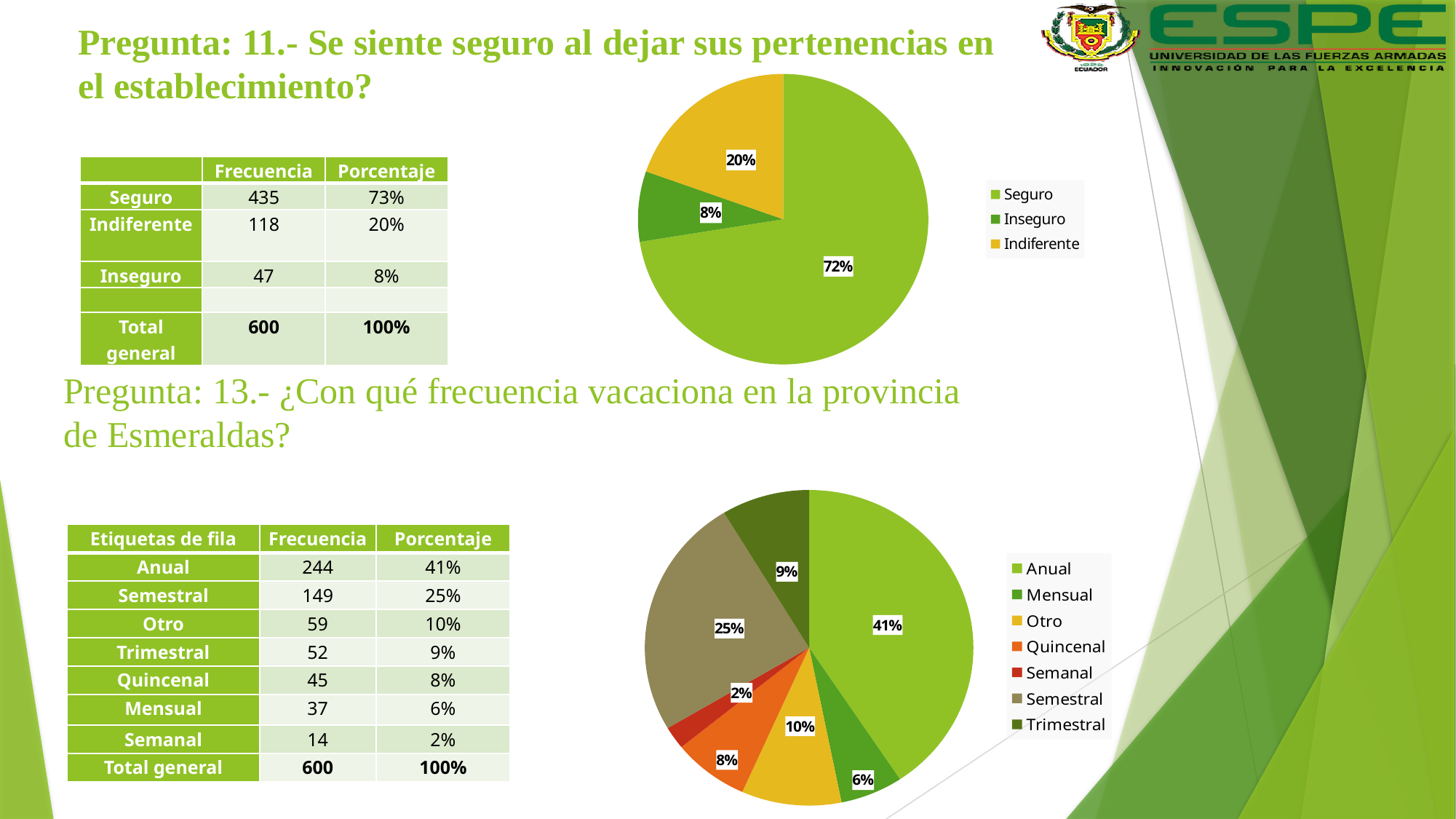
What kind of chart is the top chart (Pregunta 11)? Pie chart In the top pie chart (Pregunta 11), what percentage is shown for Indiferente? 20% In the top pie chart (Pregunta 11), what percentage is shown for Seguro? 72% In the bottom pie chart (Pregunta 13), which category has the smallest slice? Semanal In the bottom pie chart (Pregunta 13), what percentage is shown for Quincenal? 8% In the bottom pie chart (Pregunta 13), what percentage is shown for Semestral? 25% In the top pie chart (Pregunta 11), which category has the smallest slice? Inseguro In the bottom pie chart (Pregunta 13), which is larger, Otro or Trimestral? Otro In the bottom pie chart (Pregunta 13), what is the difference in percentage points between Anual and Semestral? 16 How many entries does the legend of the bottom pie chart (Pregunta 13) list? 7 In the bottom pie chart (Pregunta 13), which category has the largest slice? Anual In the top pie chart (Pregunta 11), how many slices does the pie have? 3